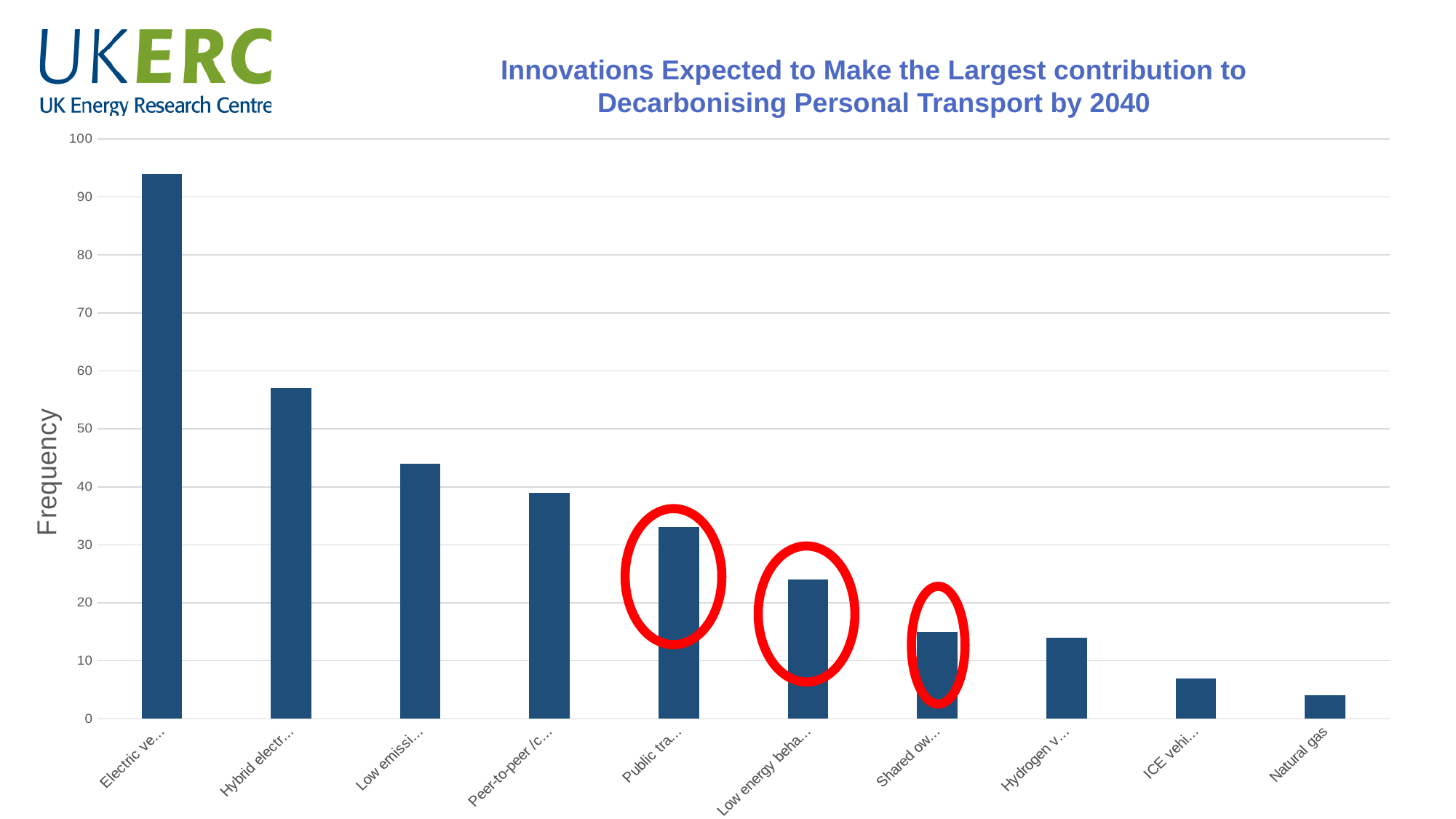
Which category has the highest frequency? Electric ve... Which category has the lowest frequency? Natural gas How many categories (bars) are plotted in the chart? 10 Is the value for Public tra... greater or less than 30? greater What kind of chart is shown on the slide? bar chart Is the value for Electric ve... greater or less than 90? greater What is the label on the vertical axis of the chart? Frequency How many bars are highlighted with red circles on the chart? 3 Is the value for Natural gas greater or less than 10? less Do the bar values rise or fall from left to right along the x axis? fall Which is larger, the value for Hybrid electr... or the value for Low emissi...? Hybrid electr...